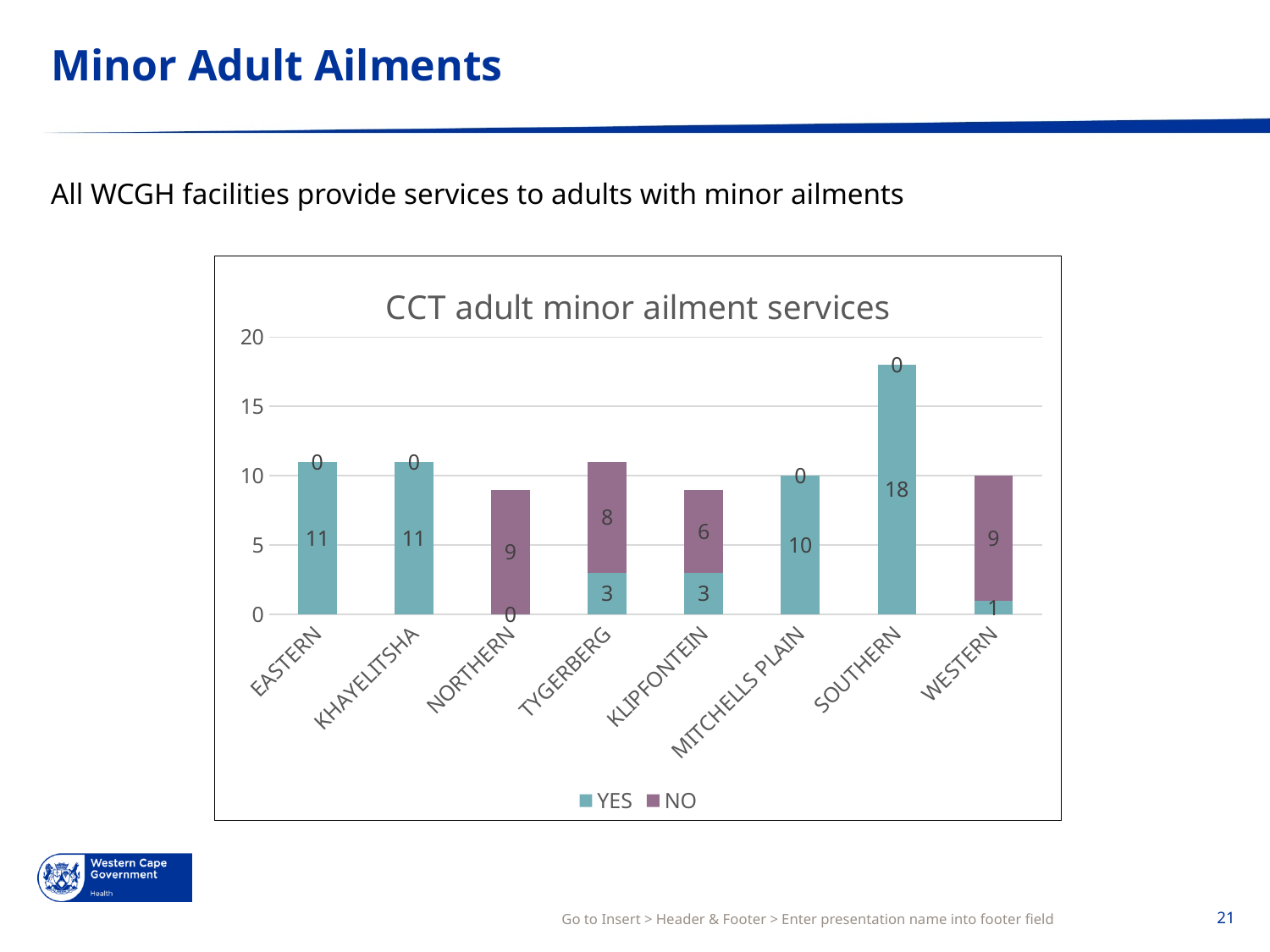
What is the YES value for SOUTHERN? 18 What is the YES value for WESTERN? 1 What is the NO value for TYGERBERG? 8 What is the title of the chart? CCT adult minor ailment services Which category has the lowest YES value? NORTHERN What is the difference between the YES value for SOUTHERN and the YES value for MITCHELLS PLAIN? 8 What is the total of the stacked bar for WESTERN? 10 What type of chart is shown on the slide? Stacked bar chart How many series does the legend list? 2 Which category has the highest YES value? SOUTHERN Which is larger, the NO value for TYGERBERG or the NO value for KLIPFONTEIN? TYGERBERG How many categories are shown on the x axis? 8